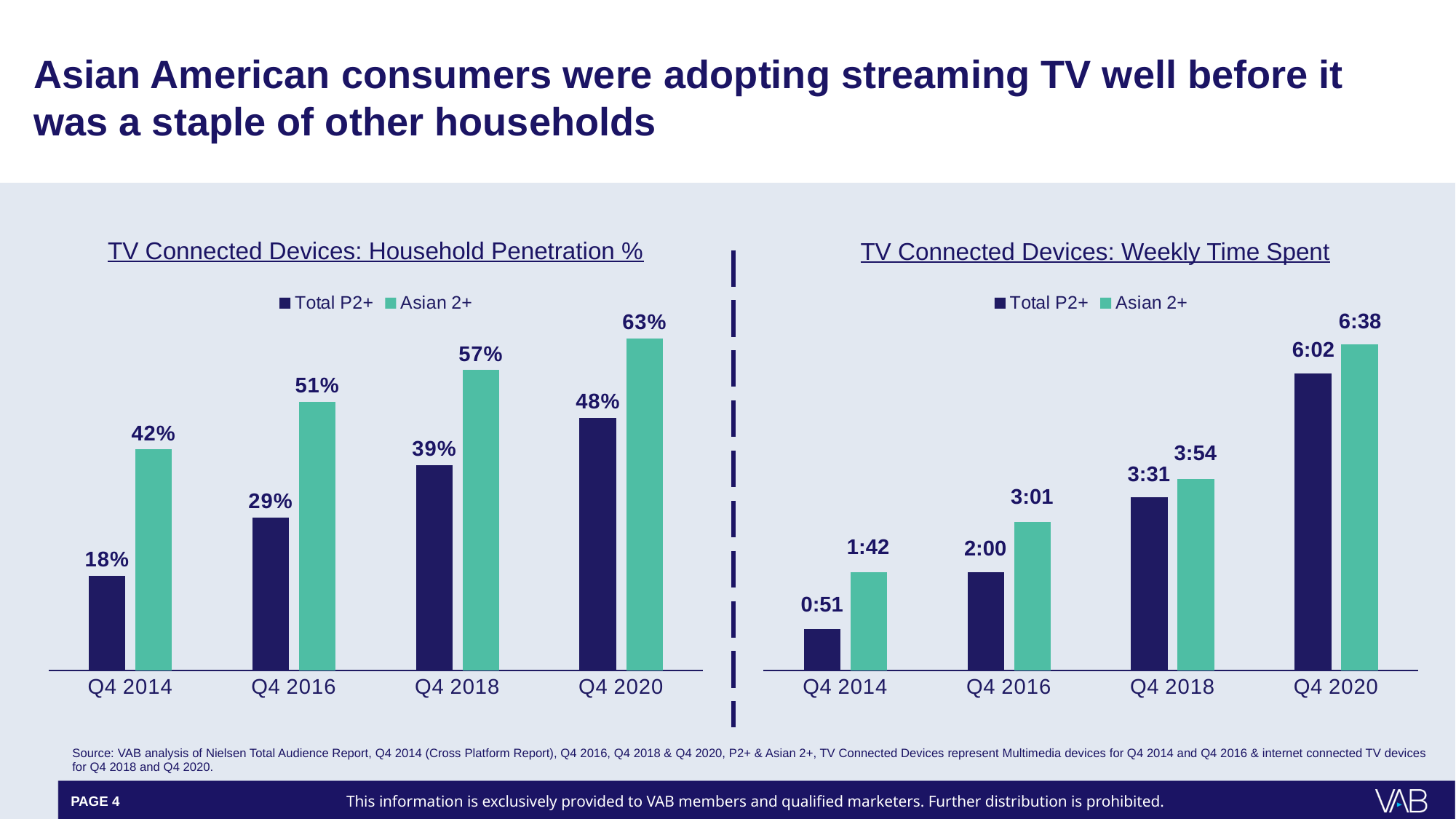
In the 'TV Connected Devices: Household Penetration %' chart, what is the value for Asian 2+ in Q4 2018? 57% What kind of chart is the 'TV Connected Devices: Weekly Time Spent' chart? Bar chart In the 'TV Connected Devices: Weekly Time Spent' chart, what is the value for Total P2+ in Q4 2016? 2:00 In the 'TV Connected Devices: Household Penetration %' chart, which is larger in Q4 2016: Total P2+ or Asian 2+? Asian 2+ In the 'TV Connected Devices: Household Penetration %' chart, which quarter has the highest Asian 2+ value? Q4 2020 In the 'TV Connected Devices: Weekly Time Spent' chart, what is the value for Asian 2+ in Q4 2020? 6:38 In the 'TV Connected Devices: Household Penetration %' chart, what is the difference between the Asian 2+ and Total P2+ values in Q4 2020? 15% How many series does the legend of the 'TV Connected Devices: Household Penetration %' chart list? 2 How many quarters are shown on the x axis of the 'TV Connected Devices: Weekly Time Spent' chart? 4 In the 'TV Connected Devices: Household Penetration %' chart, do the Total P2+ values rise or fall from Q4 2014 to Q4 2020? Rise In the 'TV Connected Devices: Weekly Time Spent' chart, which quarter has the lowest Total P2+ value? Q4 2014 In the 'TV Connected Devices: Household Penetration %' chart, what is the value for Total P2+ in Q4 2014? 18%